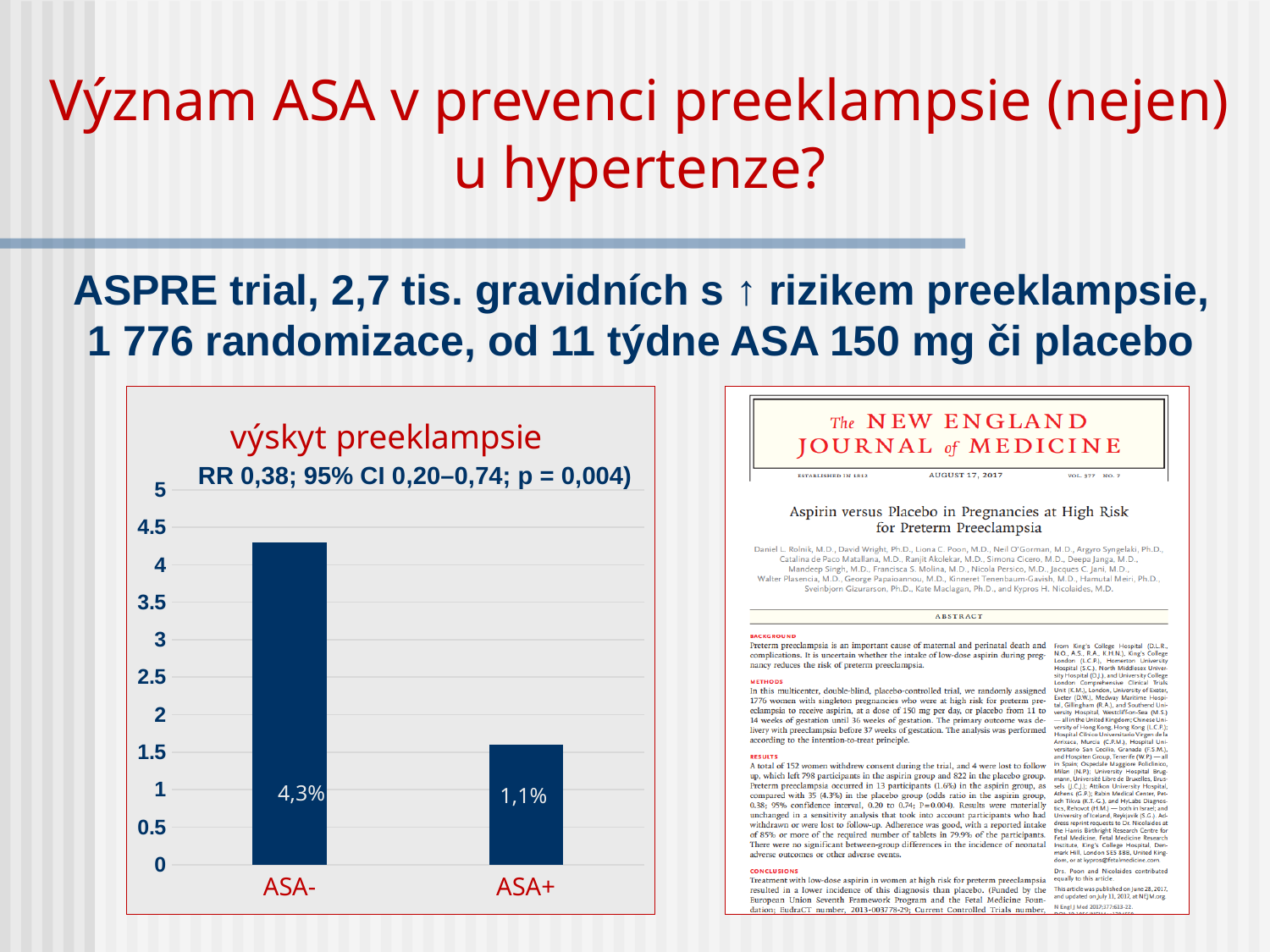
How many categories are shown on the x axis of the chart? 2 What is the difference between the values for ASA- and ASA+? 3,2% Is the value for ASA- larger or smaller than the value for ASA+? larger What kind of chart is shown on the slide? bar chart What is the value shown for ASA- in the chart? 4,3% What relative risk (RR) is stated in the chart subtitle? RR 0,38 What is the value shown for ASA+ in the chart? 1,1% Is the value for ASA- greater or less than 4? greater Which category has the higher value in the chart? ASA- What is the title of the chart? výskyt preeklampsie Which category has the lower value in the chart? ASA+